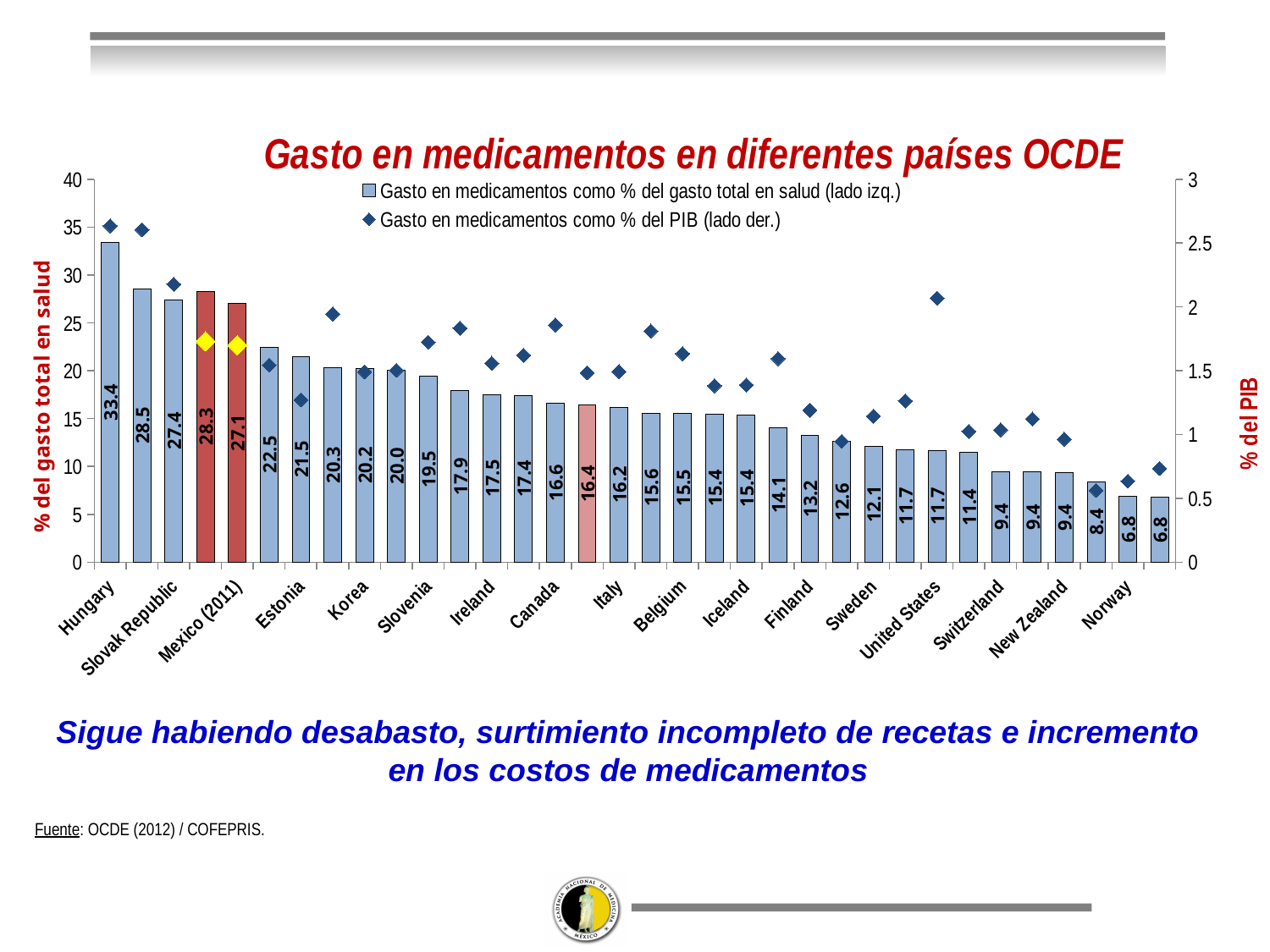
Do the bar values rise or fall from left to right along the x axis? Fall Is the % del PIB marker for Norway greater or less than 1? less What is the value for Hungary for medicine spending as % of total health spending? 33.4 What is the value for Canada for medicine spending as % of total health spending? 16.6 How many series does the legend list? 2 What is the value for Mexico (2011) for medicine spending as % of total health spending? 27.1 What is the lowest bar value shown on the chart? 6.8 Which is larger, the bar for Hungary or the bar for Mexico (2011)? Hungary What kind of chart is used for the medicine spending as % of total health spending series? Bar chart What is the difference between Hungary and Slovak Republic in medicine spending as % of total health spending? 6.0 Which country has the highest medicine spending as % of total health spending? Hungary What is the value for Estonia for medicine spending as % of total health spending? 21.5